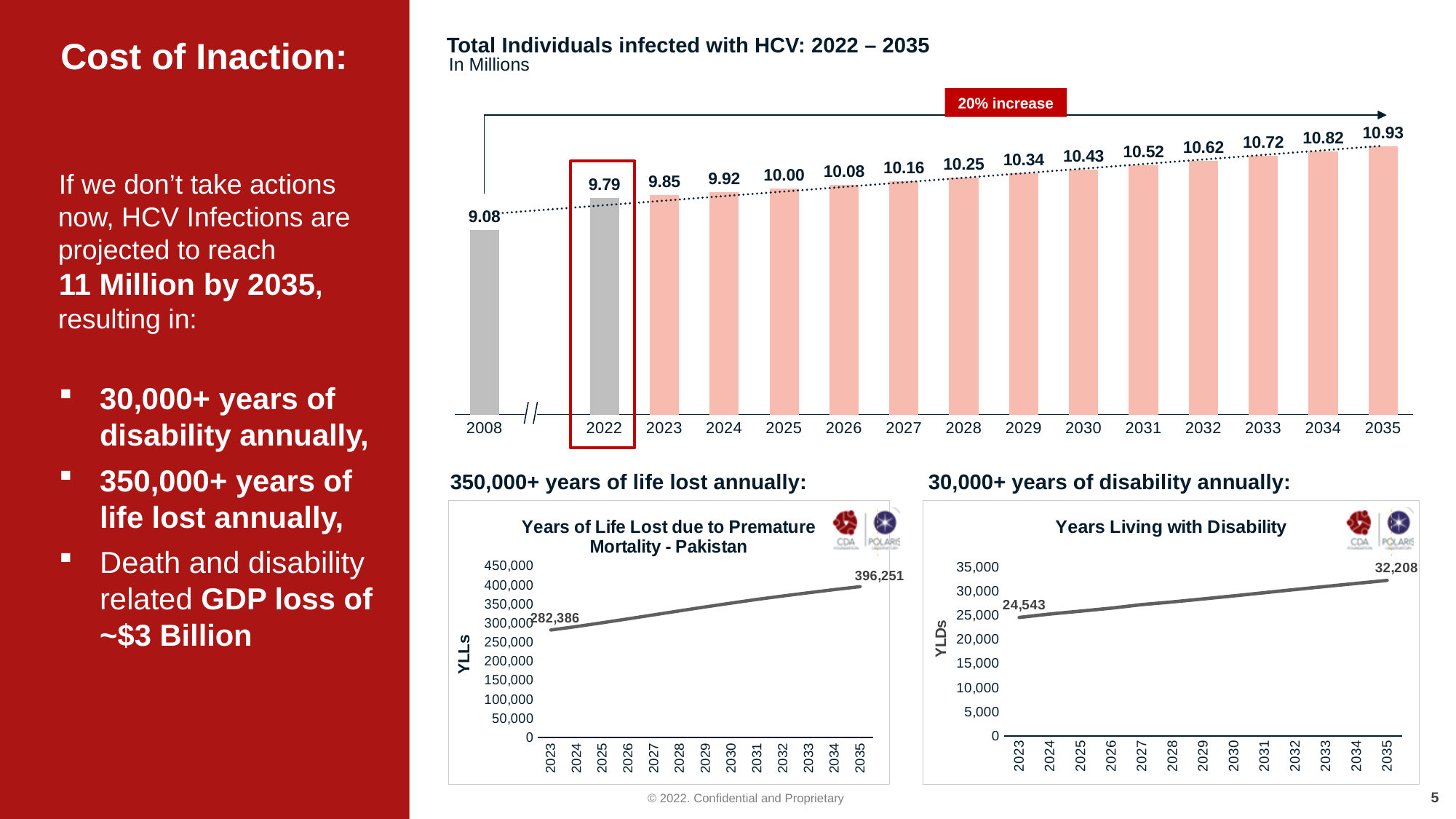
In the 'Total Individuals infected with HCV: 2022 – 2035' chart, which year has the highest value? 2035 In the 'Total Individuals infected with HCV: 2022 – 2035' chart, what is the value for 2035? 10.93 In the 'Years of Life Lost due to Premature Mortality - Pakistan' chart, what is the value for 2035? 396,251 In the 'Total Individuals infected with HCV: 2022 – 2035' chart, what is the value for 2008? 9.08 In the 'Total Individuals infected with HCV: 2022 – 2035' chart, which year has the lowest value? 2008 What kind of chart is the 'Total Individuals infected with HCV: 2022 – 2035' chart? Bar chart What percentage increase is called out in the red label on the 'Total Individuals infected with HCV: 2022 – 2035' chart? 20% increase How many bars are shown in the 'Total Individuals infected with HCV: 2022 – 2035' chart? 15 In the 'Years Living with Disability' chart, what is the difference between the 2035 value and the 2023 value? 7,665 In the 'Years Living with Disability' chart, what is the value for 2023? 24,543 In the 'Total Individuals infected with HCV: 2022 – 2035' chart, do the values rise or fall from 2022 to 2035? Rise In the 'Total Individuals infected with HCV: 2022 – 2035' chart, what is the difference between the 2035 value and the 2022 value? 1.14